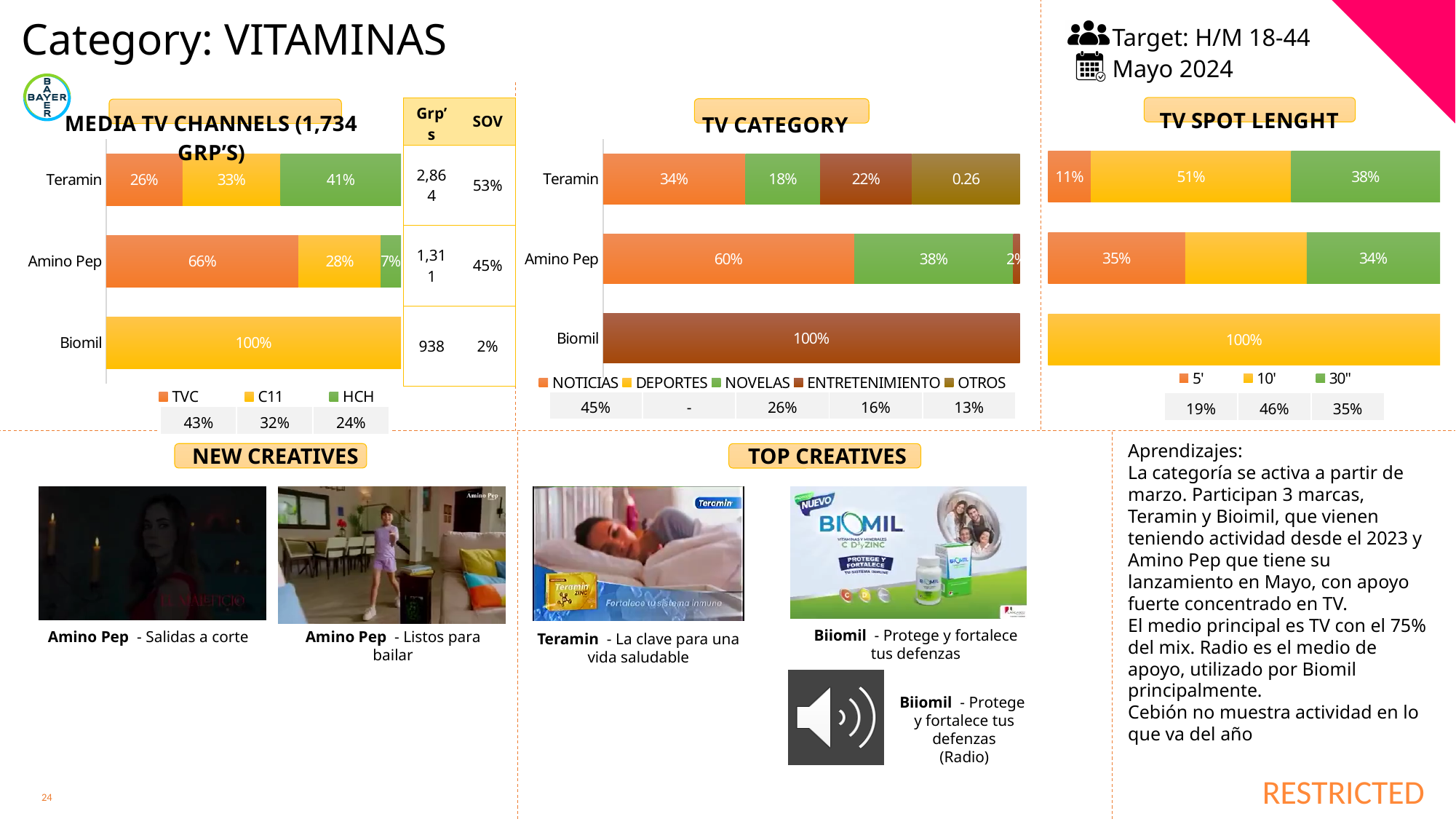
In the TV CATEGORY chart, what is the ENTRETENIMIENTO share for Teramin? 22% In the TV SPOT LENGHT chart, what is the 5' share for Amino Pep? 35% In the MEDIA TV CHANNELS chart, how many series does the legend list? 3 What type of chart is the TV SPOT LENGHT chart? Stacked bar chart In the MEDIA TV CHANNELS chart, which brand has 100% of its share in C11? Biomil In the TV SPOT LENGHT chart, what is the 10' share for Teramin? 51% In the TV CATEGORY chart, what is the NOTICIAS share for Amino Pep? 60% In the TV CATEGORY chart, how many series does the legend list? 5 In the TV CATEGORY chart, which is larger for Teramin: the NOTICIAS share or the NOVELAS share? NOTICIAS In the MEDIA TV CHANNELS chart, what is the TVC share for Amino Pep? 66% In the MEDIA TV CHANNELS chart, what is the difference between the TVC share and the C11 share for Amino Pep? 38% In the MEDIA TV CHANNELS chart, what is the HCH share for Teramin? 41%